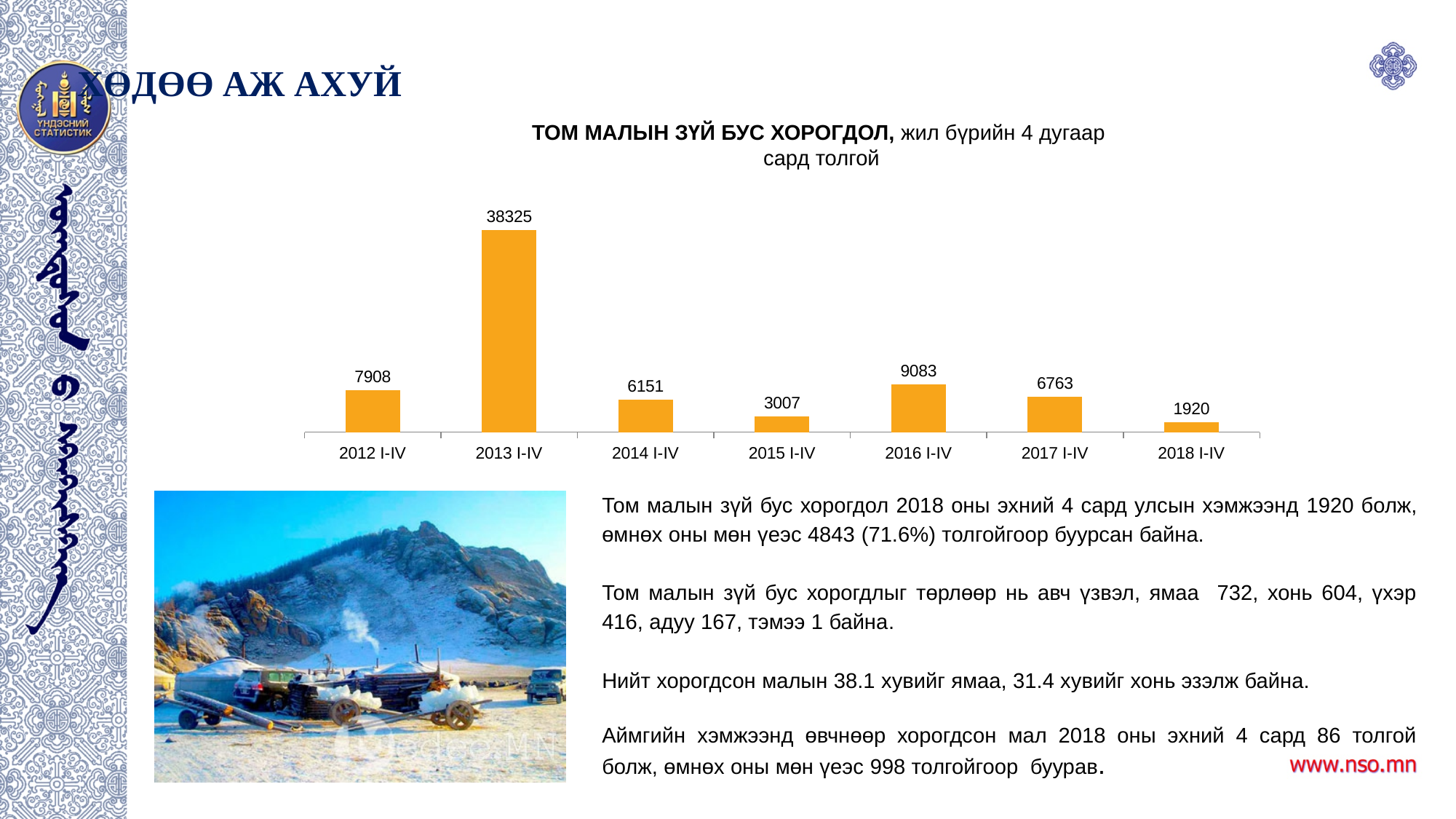
What is the difference between the values for 2017 I-IV and 2018 I-IV? 4843 What is the value for 2015 I-IV? 3007 What kind of chart is shown on the slide? bar chart What is the difference between the values for 2012 I-IV and 2014 I-IV? 1757 Do the values rise or fall from 2016 I-IV to 2018 I-IV? fall How many periods are shown on the x axis? 7 Which period has the lowest value? 2018 I-IV What is the value for 2013 I-IV? 38325 Which is larger, the value for 2016 I-IV or the value for 2017 I-IV? 2016 I-IV What colour are the bars in the chart? orange What is the value for 2018 I-IV? 1920 Which period has the highest value? 2013 I-IV